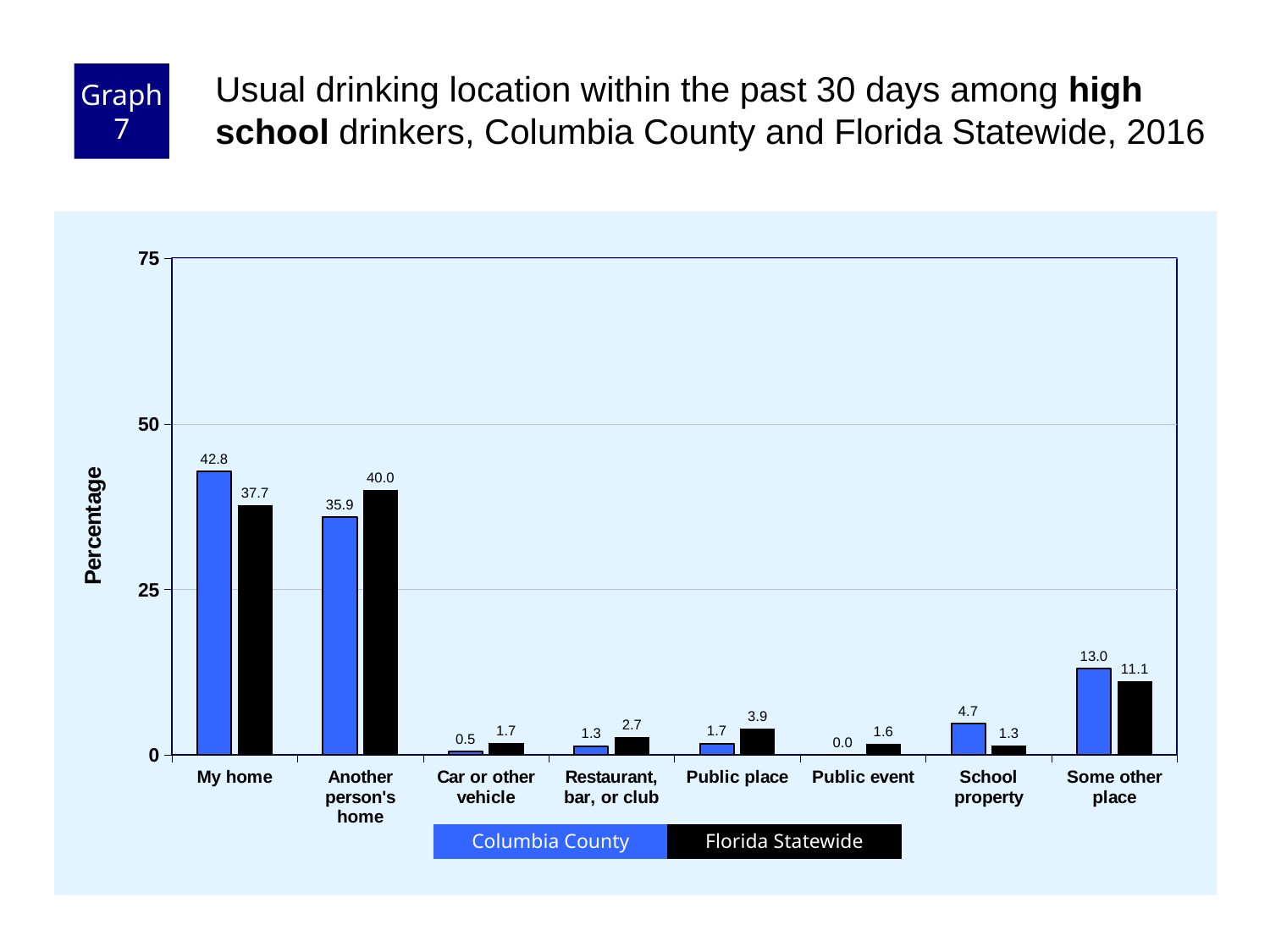
What kind of chart is shown? bar chart How many series does the legend list? 2 What is the Columbia County value for Public event? 0.0 Is the Columbia County value for Another person's home greater or less than 25? greater What is the difference between the Columbia County and Florida Statewide values for Some other place? 1.9 Which category has the highest Columbia County value? My home What is the Florida Statewide value for Another person's home? 40.0 What is the label of the y axis? Percentage What is the Columbia County value for My home? 42.8 How many categories are shown on the x axis? 8 Which category has the lowest Florida Statewide value? School property Which is larger for Public place: Columbia County or Florida Statewide? Florida Statewide